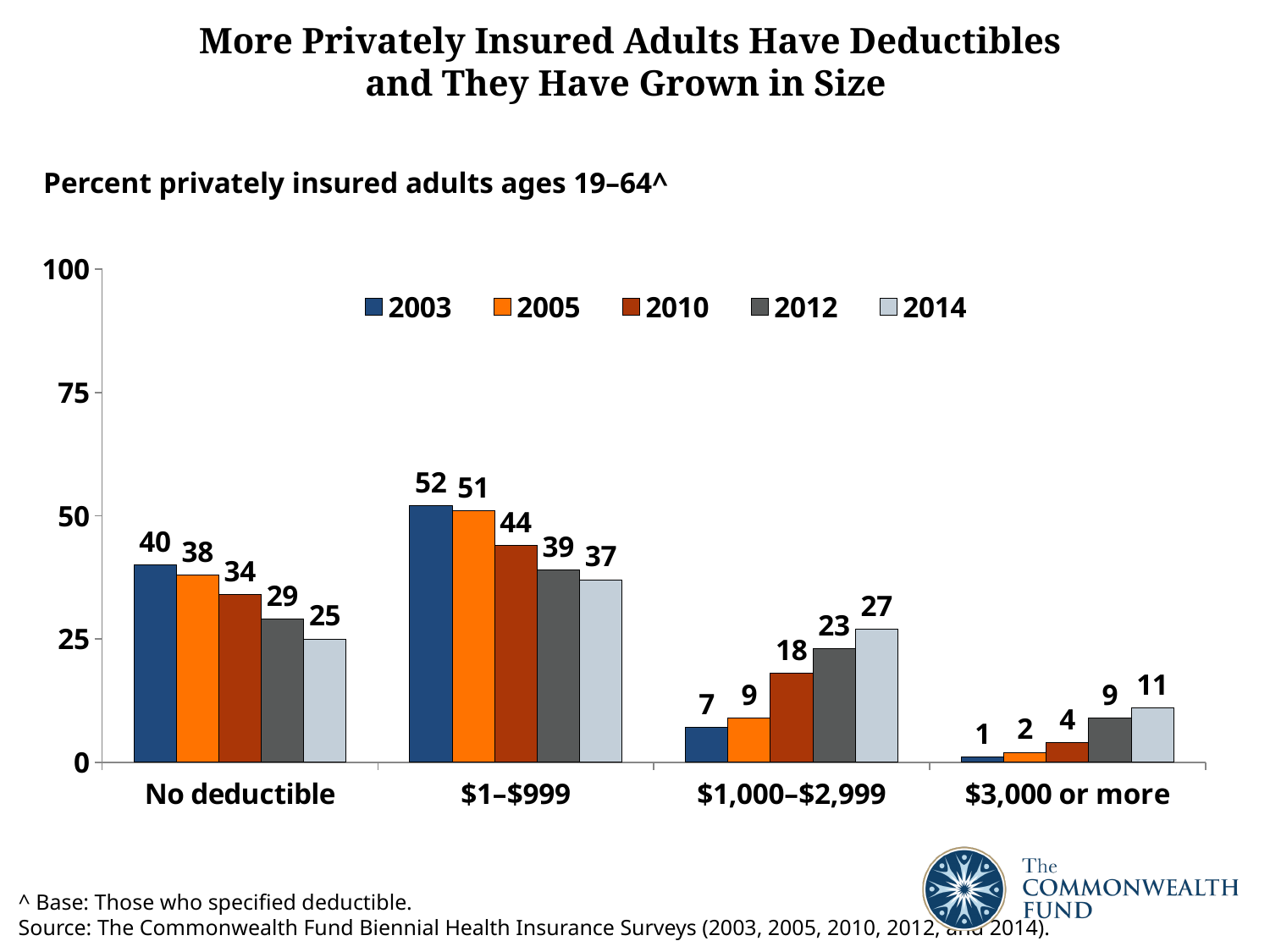
What is the value for 2010 in the "$1,000–$2,999" category? 18 Do the values in the "$3,000 or more" category rise or fall from 2003 to 2014? Rise What is the value for 2014 in the "No deductible" category? 25 Is the 2014 value for "$1,000–$2,999" greater or less than 25? greater Which is larger: the 2012 value for "$1–$999" or the 2012 value for "$1,000–$2,999"? $1–$999 How many series does the legend list? 5 Which year has the highest value in the "$3,000 or more" category? 2014 What is the difference between the 2003 and 2014 values in the "No deductible" category? 15 Which year has the lowest value in the "No deductible" category? 2014 How many deductible categories are shown on the x axis? 4 What kind of chart is shown on the slide? Bar chart What is the value for 2003 in the "$1–$999" category? 52